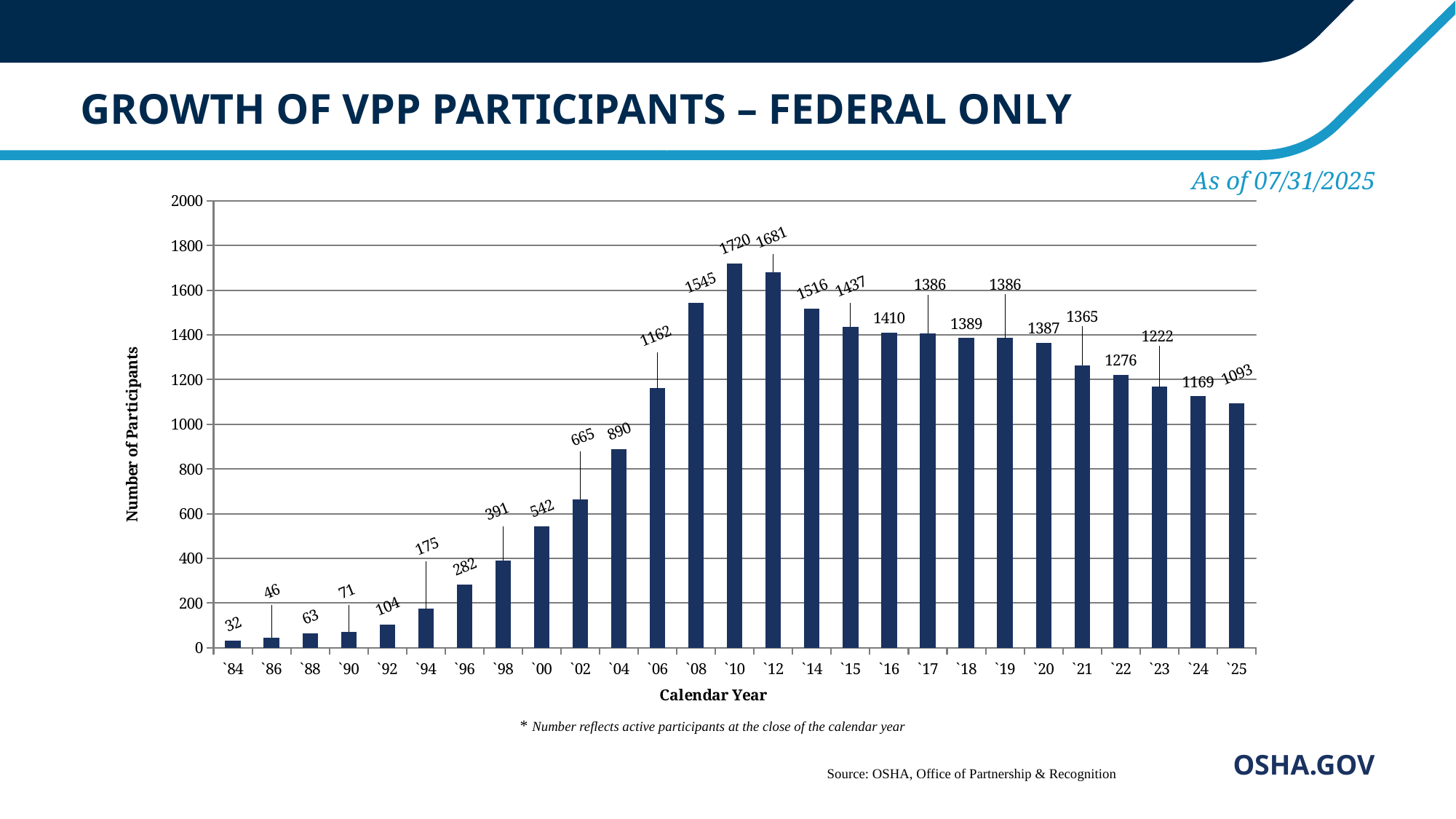
Which year has more participants, '04 or '06? '06 What is the label of the y axis? Number of Participants How many participants were there in '10? 1720 What is the difference in participants between '10 and '12? 39 What is the difference in participants between '08 and '06? 383 What is the number of participants for '25? 1093 Which calendar year has the highest number of participants? '10 How many calendar years are shown on the x axis? 27 What is the value shown for '98? 391 What type of chart is shown on the slide? bar chart Which calendar year has the lowest number of participants? '84 Do the values rise or fall from '84 to '10? rise